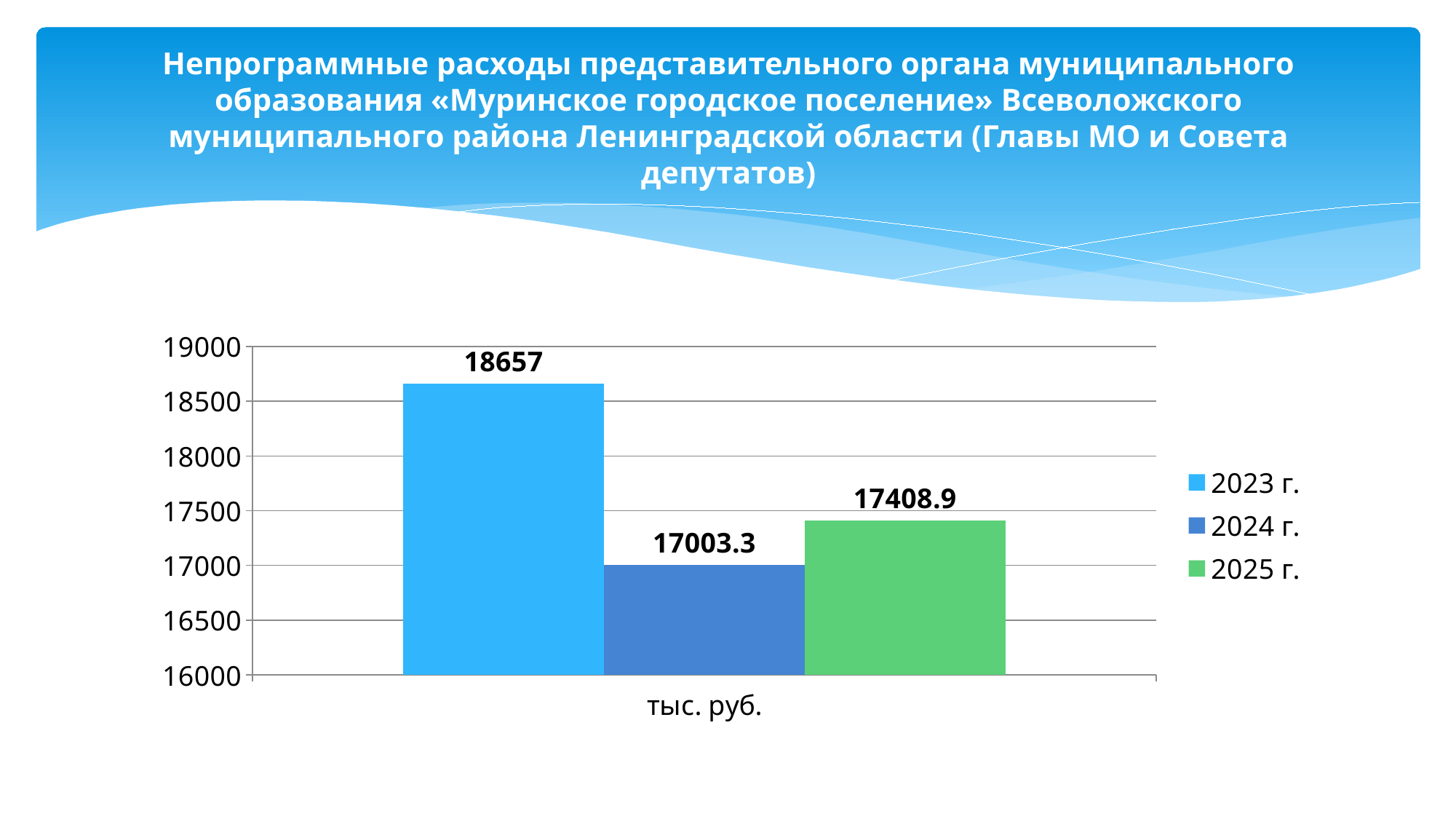
What kind of chart is shown on the slide? bar chart How many series does the legend list? 3 What is the value for 2024 г.? 17003.3 What is the difference between the values for 2023 г. and 2024 г.? 1653.7 Is the value for 2024 г. greater or less than 17500? less Which year has the highest value? 2023 г. What unit label is shown under the x axis of the chart? тыс. руб. What is the value for 2023 г.? 18657 Which year has the lowest value? 2024 г. Which is larger, the value for 2025 г. or the value for 2024 г.? 2025 г. What is the difference between the values for 2025 г. and 2024 г.? 405.6 What is the value for 2025 г.? 17408.9